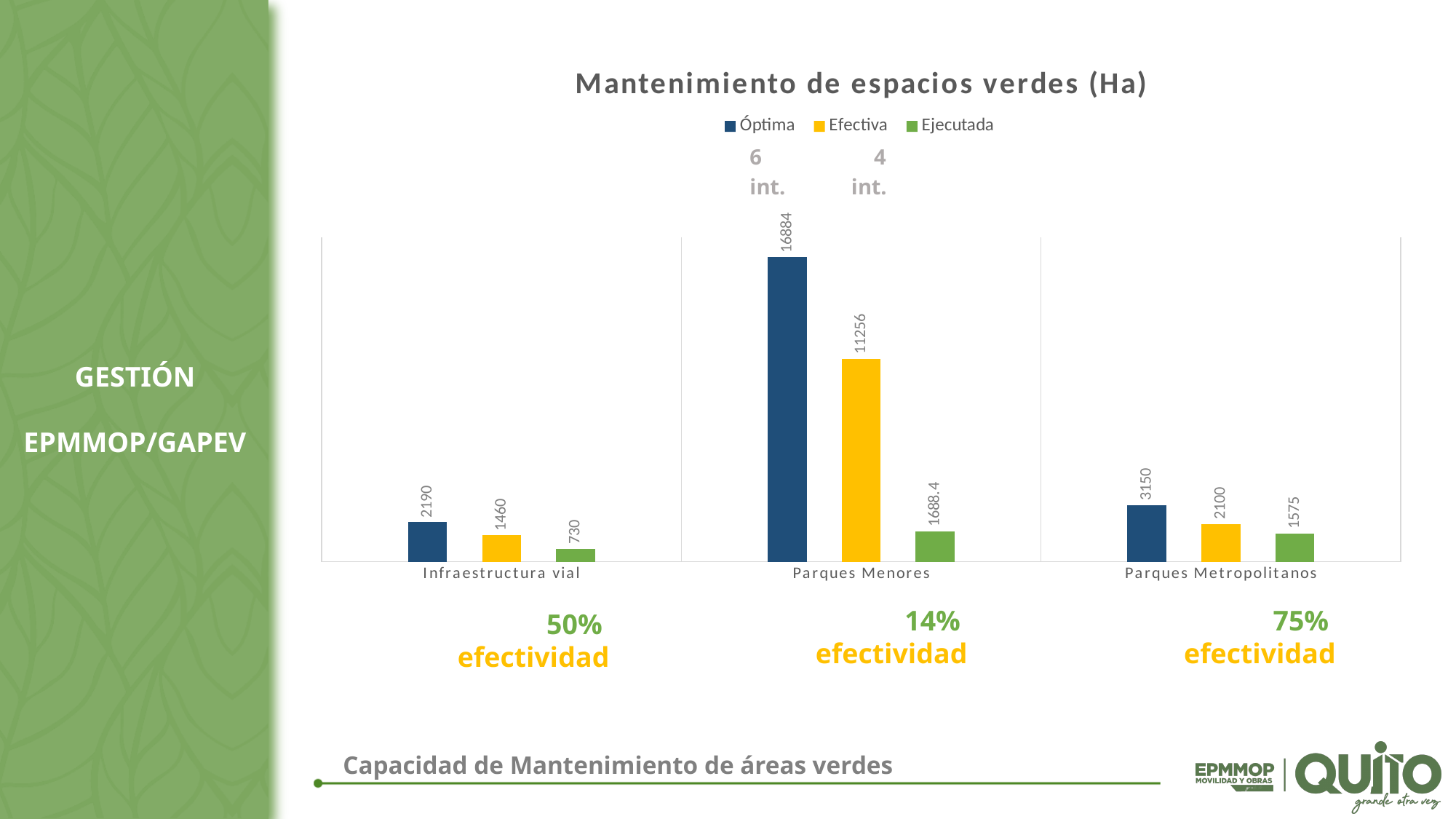
How many categories are shown on the x axis? 3 What is the Óptima value for Parques Menores? 16884 What is the Ejecutada value for Parques Metropolitanos? 1575 What is the difference between the Óptima and Efectiva values for Parques Metropolitanos? 1050 Which category has the lowest Ejecutada value? Infraestructura vial What is the Efectiva value for Infraestructura vial? 1460 What is the title of the chart? Mantenimiento de espacios verdes (Ha) Which category has the highest Óptima value? Parques Menores What is the Ejecutada value for Parques Menores? 1688.4 Which is larger, the Efectiva value for Parques Menores or the Óptima value for Parques Metropolitanos? Efectiva value for Parques Menores How many series does the legend list? 3 What type of chart is shown on the slide? bar chart